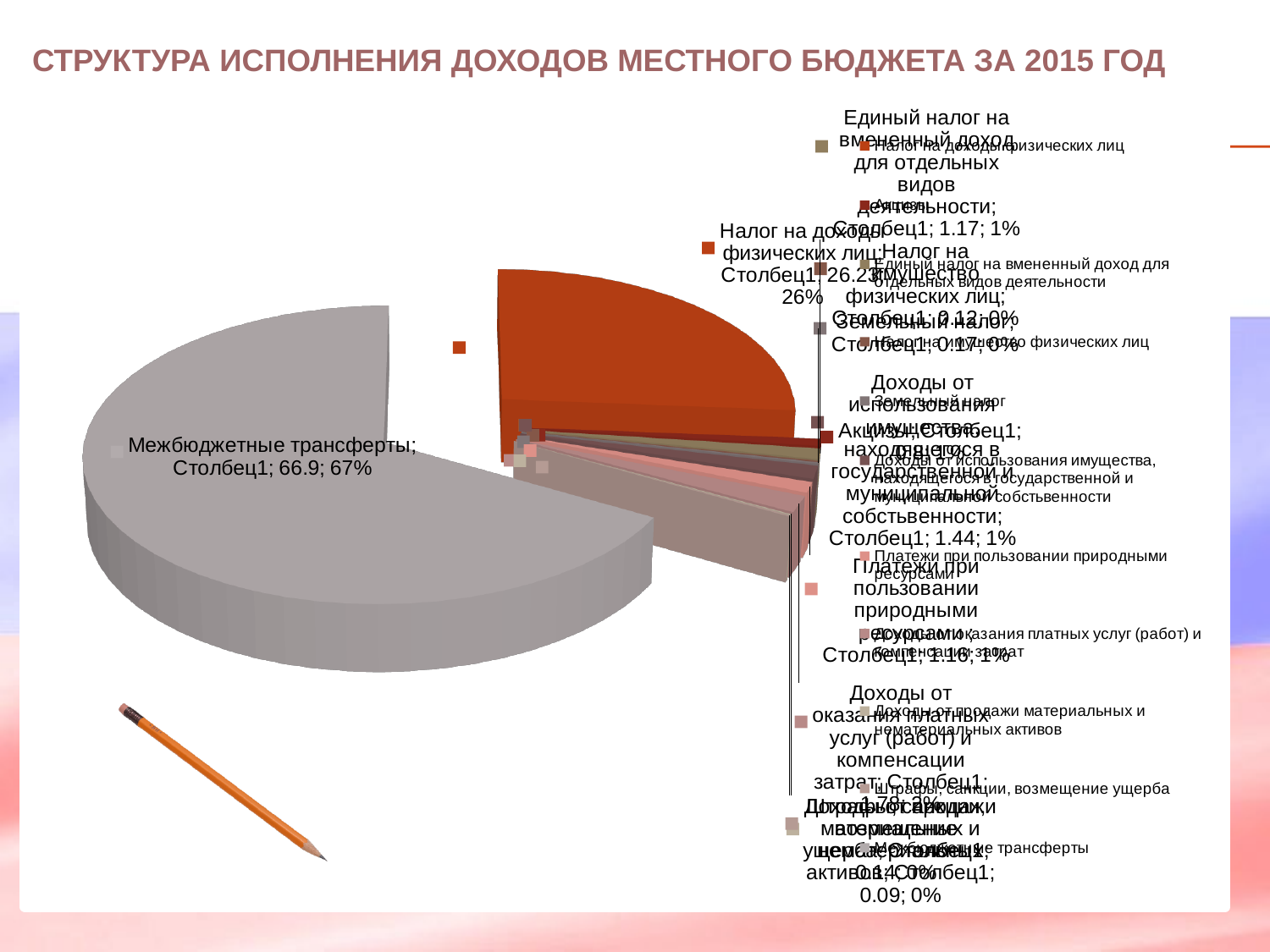
What kind of chart is shown on the slide? pie chart What share of the pie does Межбюджетные трансферты take? 67% What value is shown for Налог на доходы физических лиц? 26.23 What value is shown for Доходы от использования имущества, находящегося в государственной и муниципальной собственности? 1.44 What share of the pie does Налог на доходы физических лиц take? 26% What value is shown for Единый налог на вмененный доход для отдельных видов деятельности? 1.17 Which category has the largest slice of the pie? Межбюджетные трансферты What is the title of the chart on the slide? СТРУКТУРА ИСПОЛНЕНИЯ ДОХОДОВ МЕСТНОГО БЮДЖЕТА ЗА 2015 ГОД What value is shown for Межбюджетные трансферты? 66.9 What value is shown for Доходы от оказания платных услуг (работ) и компенсации затрат? 1.78 What is the difference between the values for Межбюджетные трансферты and Налог на доходы физических лиц? 40.67 How many categories does the legend list? 11